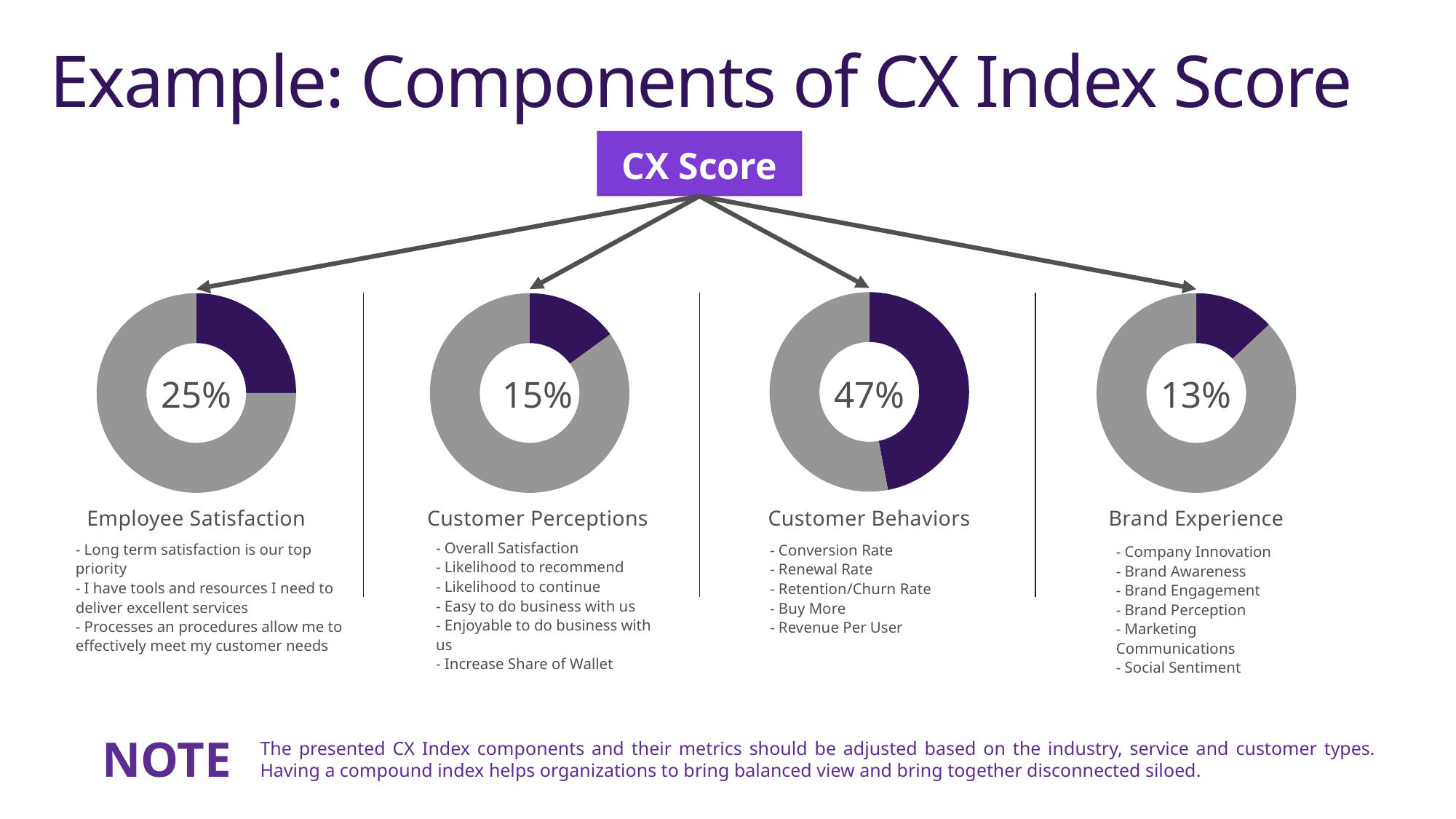
Which is larger, the Employee Satisfaction percentage or the Customer Perceptions percentage? Employee Satisfaction What is the difference between the Customer Behaviors percentage and the Employee Satisfaction percentage? 22% What percentage is shown in the Customer Perceptions donut chart? 15% What percentage is shown in the Employee Satisfaction donut chart? 25% Across the four donut charts, which component has the lowest percentage? Brand Experience What is the difference between the Customer Perceptions percentage and the Brand Experience percentage? 2% Across the four donut charts, which component has the highest percentage? Customer Behaviors What percentage is shown in the Brand Experience donut chart? 13% What is the total of the four component percentages shown in the donut charts? 100% What type of chart is used to show each CX Index component? Donut chart How many donut charts are shown on the slide? 4 What percentage is shown in the Customer Behaviors donut chart? 47%